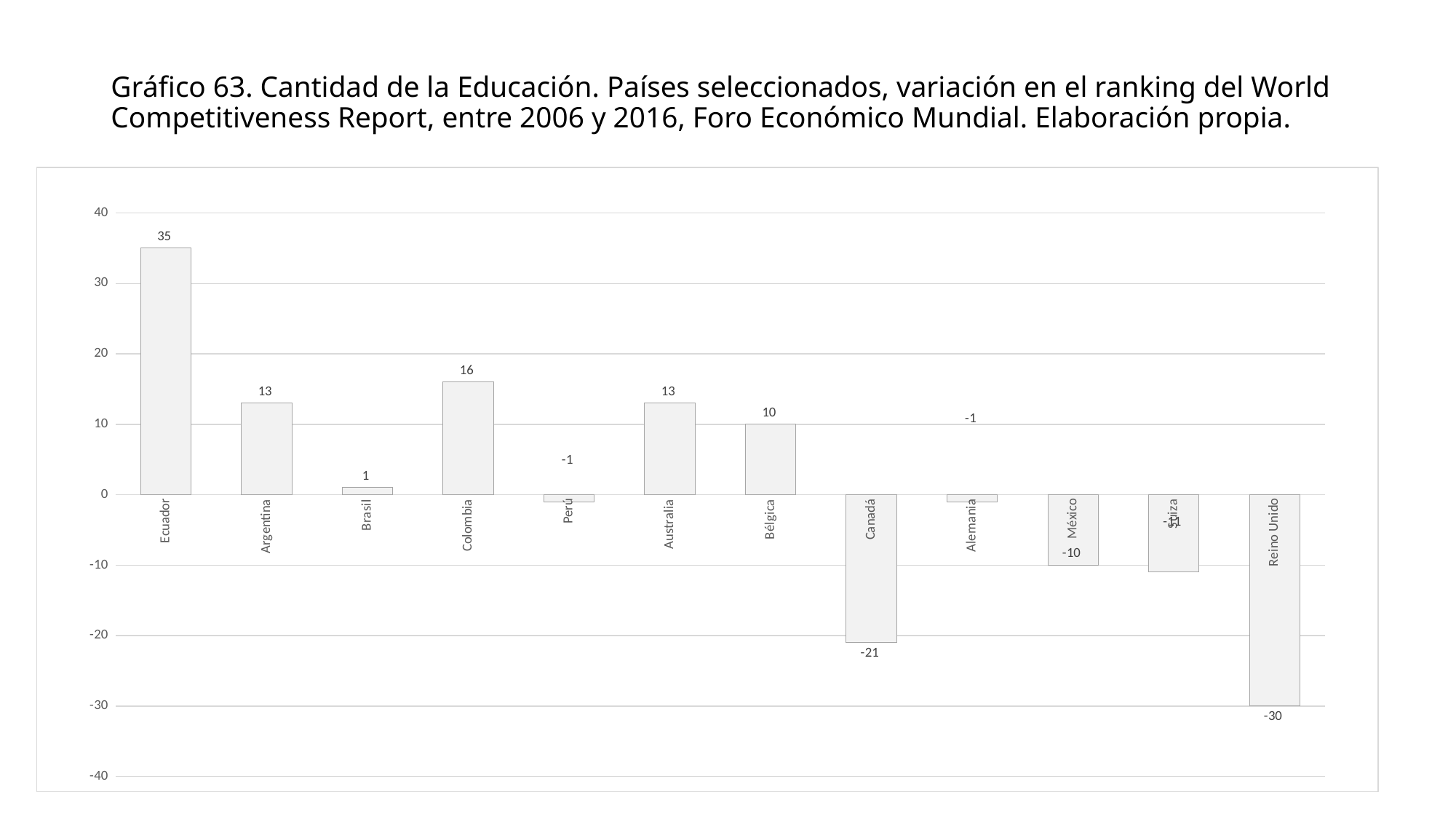
Is the value for Reino Unido greater or less than -20? less What kind of chart is shown on the slide? bar chart What is the value for Ecuador? 35 What is the value for Bélgica? 10 Which country has the highest value in the chart? Ecuador What is the difference between the values for Ecuador and Colombia? 19 Which country has the lowest value in the chart? Reino Unido Which has the larger value, Argentina or Colombia? Colombia How many countries are plotted in the chart? 12 What is the value for Colombia? 16 Which organisation's report is cited in the chart title as the source of the ranking? World Competitiveness Report, Foro Económico Mundial What is the value for Canadá? -21